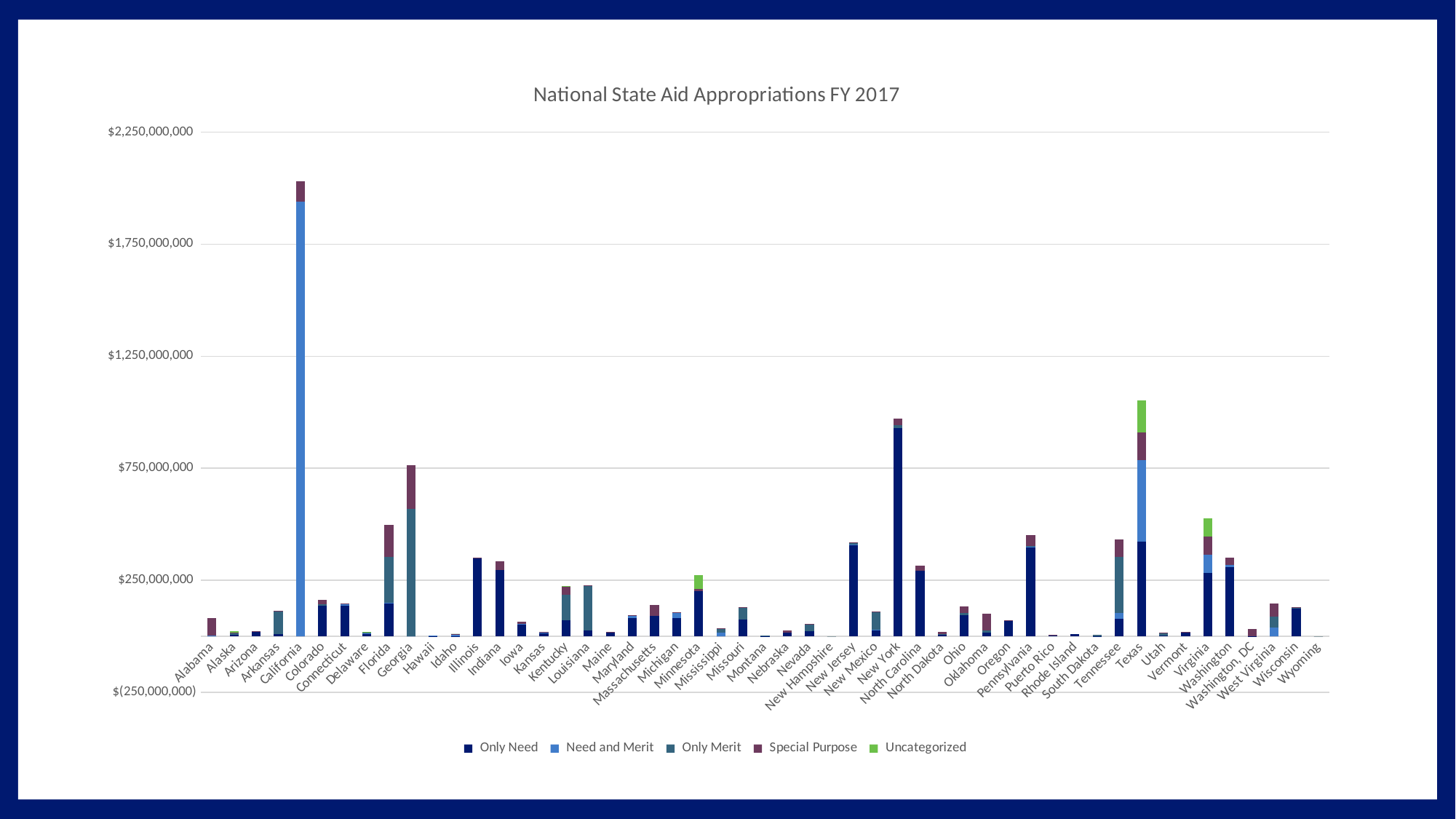
Is the total value for New York greater or less than $750,000,000? greater Is the total value for California greater or less than $1,750,000,000? greater What type of chart is shown on the slide? Stacked bar chart Is the total value for Illinois greater or less than $250,000,000? greater Which state has the highest total state aid appropriation? California How many series does the legend list? 5 How many states/territories are shown on the x axis? 51 What is the title of the chart? National State Aid Appropriations FY 2017 Which series makes up almost all of California's bar? Need and Merit Which has a larger total, New York or Georgia? New York Which has a larger total, California or Texas? California